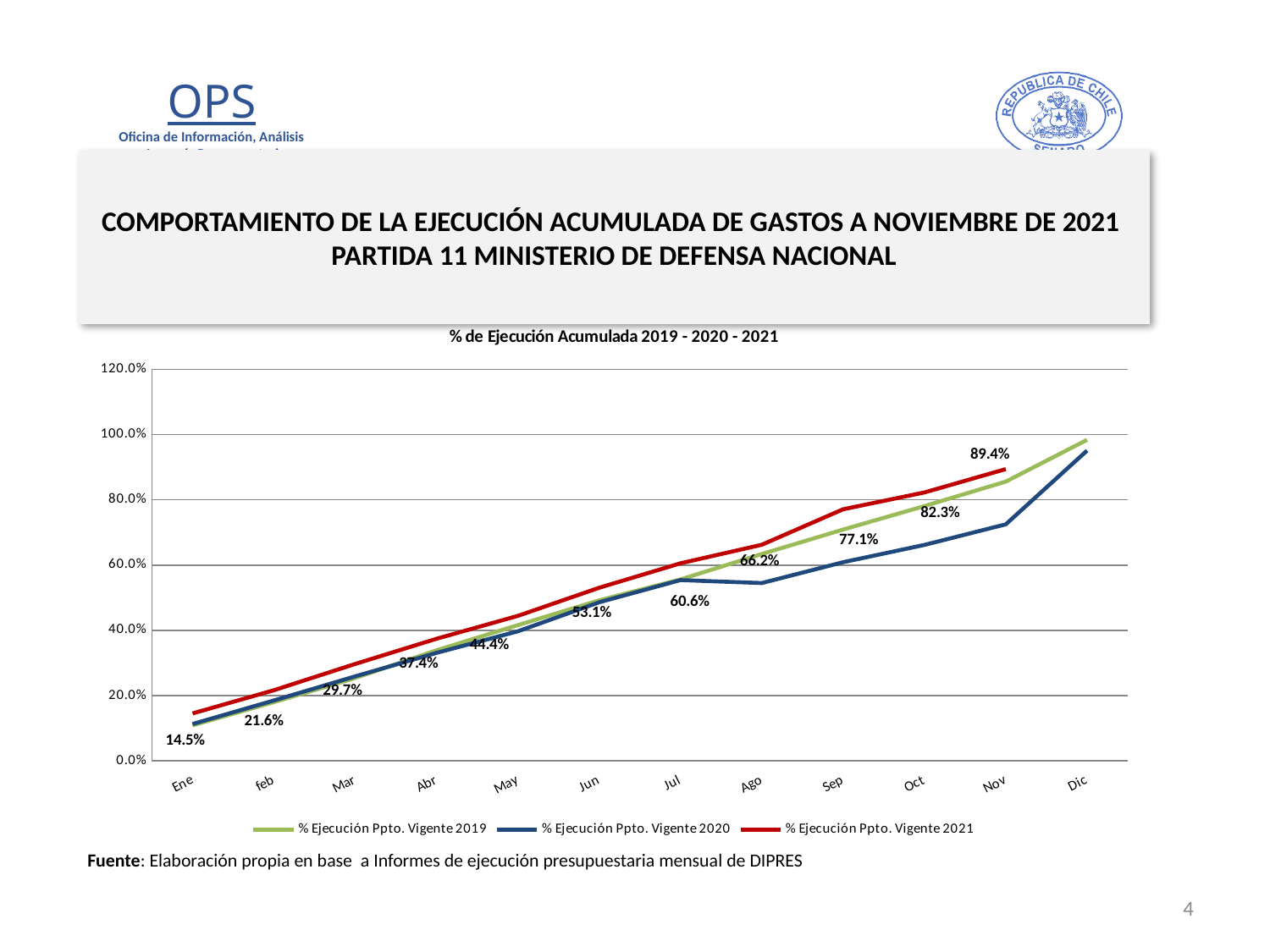
Is the value for % Ejecución Ppto. Vigente 2020 in Nov greater or less than 80.0%? less What is the difference between the 2021 values for Nov and Oct? 7.1 percentage points Does the % Ejecución Ppto. Vigente 2021 series rise or fall from Ene to Nov? Rise What kind of chart is shown on the slide? Line chart How many months are shown on the x axis? 12 In Nov, which series is larger: % Ejecución Ppto. Vigente 2021 or % Ejecución Ppto. Vigente 2020? % Ejecución Ppto. Vigente 2021 What is the value of % Ejecución Ppto. Vigente 2021 in Ene? 14.5% What is the value of % Ejecución Ppto. Vigente 2021 in Nov? 89.4% What is the difference between the 2021 values for Ago and Jul? 5.6 percentage points How many series does the legend list? 3 What is the title of the chart? % de Ejecución Acumulada 2019 - 2020 - 2021 What is the value of % Ejecución Ppto. Vigente 2021 in Jul? 60.6%